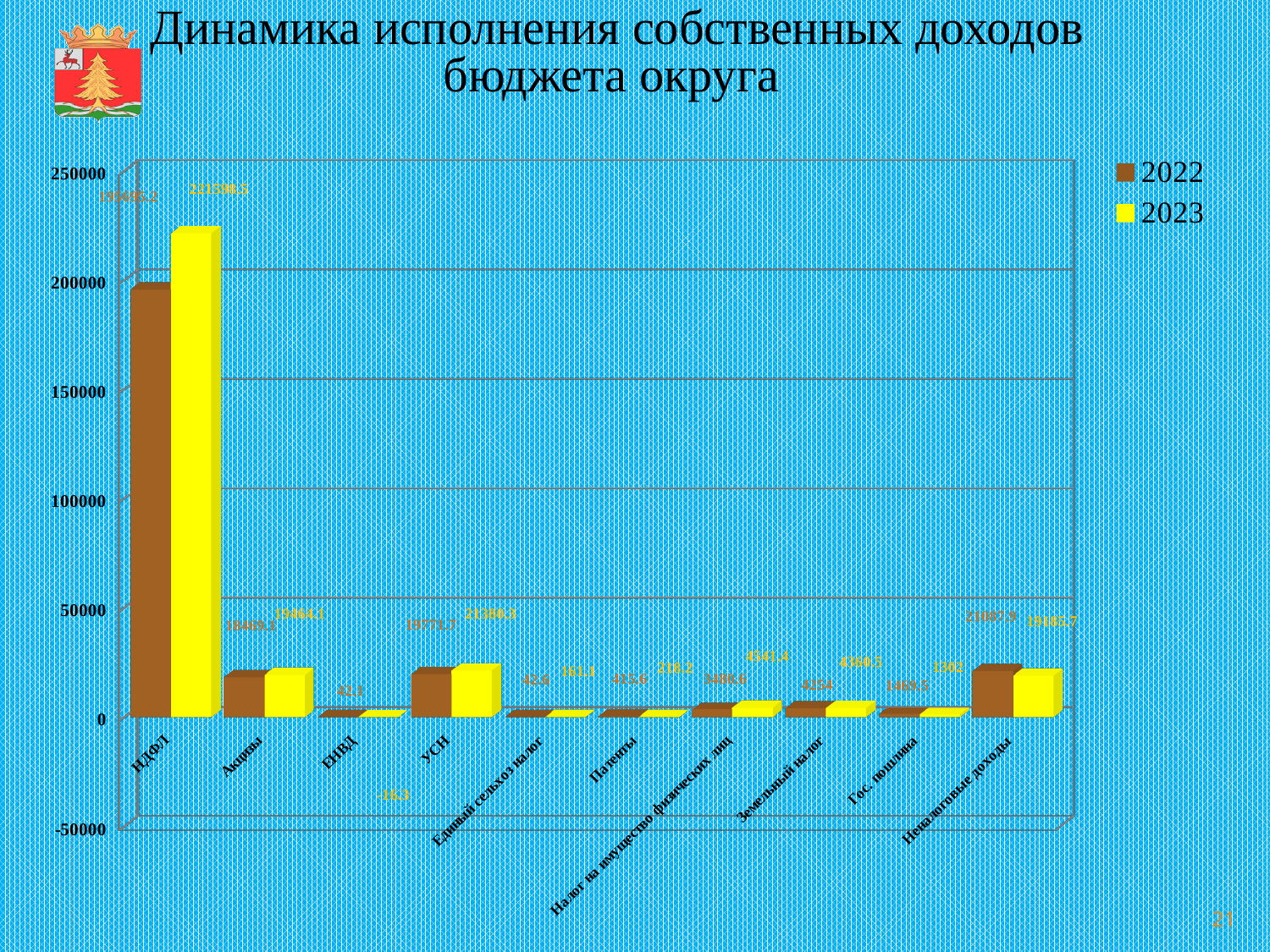
Is the 2023 value for НДФЛ greater or less than 200000? greater Which category has the highest value for 2022? НДФЛ How many categories are shown on the x axis? 10 What kind of chart is shown on the slide? Bar chart What is the 2023 value for ЕНВД? -16.3 What is the title of the chart? Динамика исполнения собственных доходов бюджета округа How many series does the legend list? 2 For НДФЛ, which year has the larger value, 2022 or 2023? 2023 Is the 2022 value for Акцизы greater or less than 50000? less For УСН, which year has the larger value, 2022 or 2023? 2023 Which category has the highest value for 2023? НДФЛ Which years are listed in the legend? 2022 and 2023